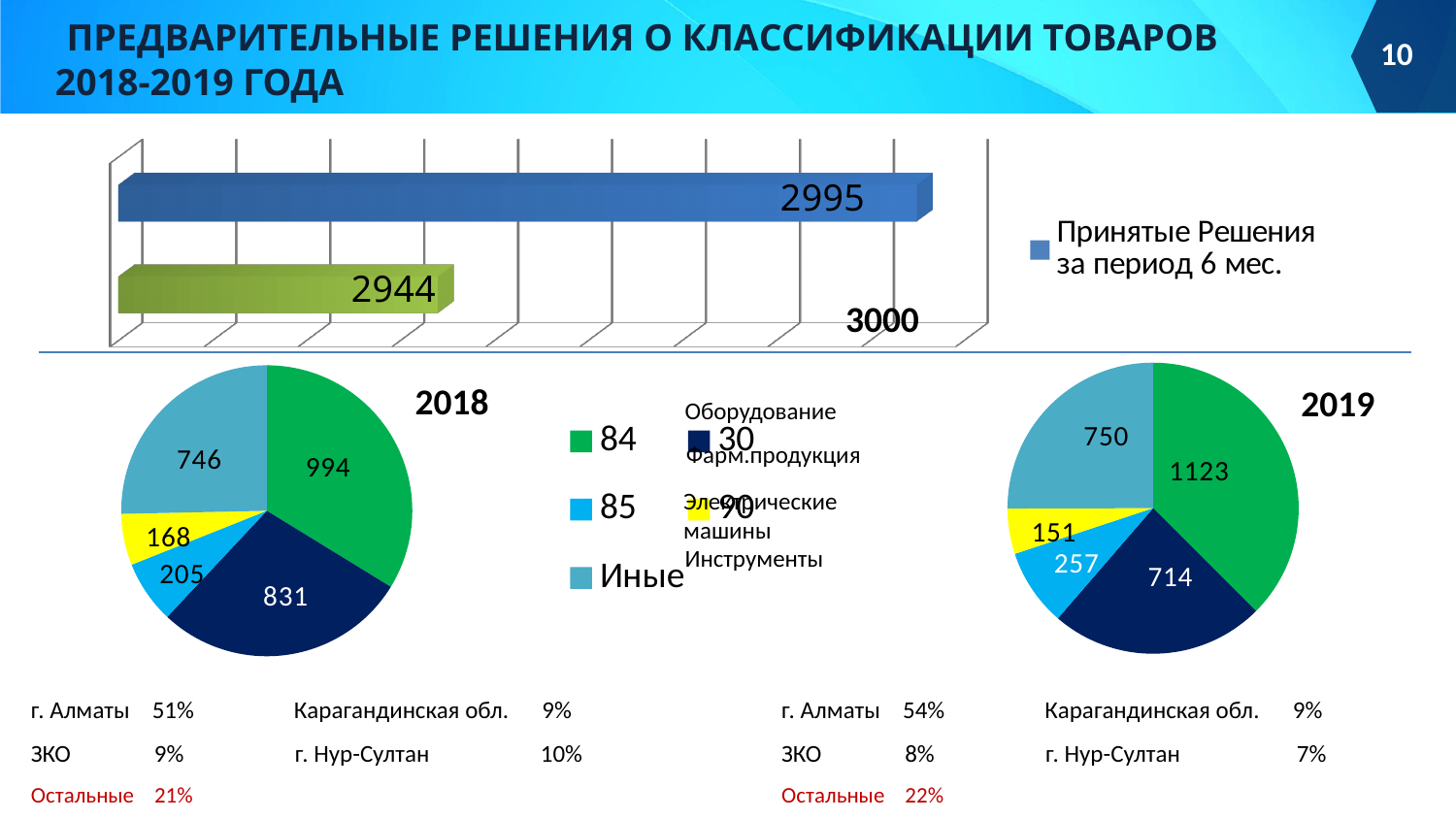
In the 2019 pie chart, what is the value of the largest slice? 1123 In the bar chart at the top of the slide, what is the value of the longest bar? 2995 What is the legend entry of the bar chart at the top of the slide? Принятые Решения за период 6 мес. How many bars are in the bar chart at the top of the slide? 2 In the 2018 pie chart, what is the value of the smallest slice? 168 In the bar chart at the top of the slide, what is the value of the shorter (green) bar? 2944 In the bar chart at the top of the slide, what is the difference between the two bars? 51 What kind of chart is the chart at the top of the slide? bar chart In the 2018 pie chart, what is the value of the largest slice? 994 How many slices does the 2019 pie chart have? 5 In the bar chart at the top of the slide, is the value of the longest bar greater or less than 3000? less In the 2019 pie chart, what is the value of the smallest slice? 151